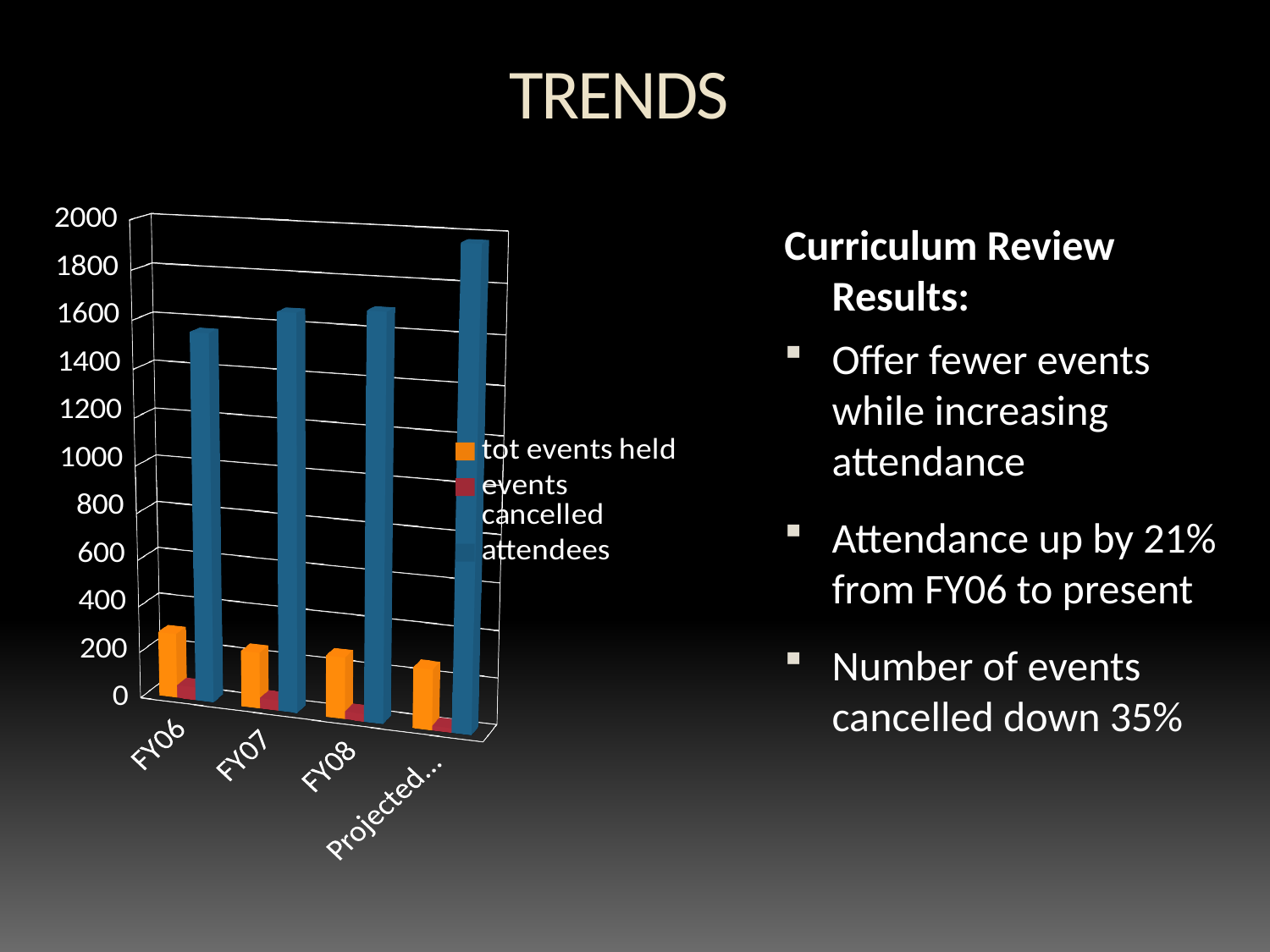
Is the value for attendees in FY06 greater or less than 1000? greater Which is larger: attendees in FY06 or attendees in Projected...? Projected... Which category has the highest value for attendees? Projected... Which category has the highest value for tot events held? FY06 Is the value for tot events held in FY06 greater or less than 400? less What kind of chart is shown on the slide? bar chart Do the values for tot events held rise or fall from FY06 to Projected...? fall How many series does the chart's legend list? 3 Which category has the lowest value for tot events held? FY07 Which category has the lowest value for attendees? FY06 How many categories are shown on the x axis of the chart? 4 What colour are the bars for the attendees series? blue